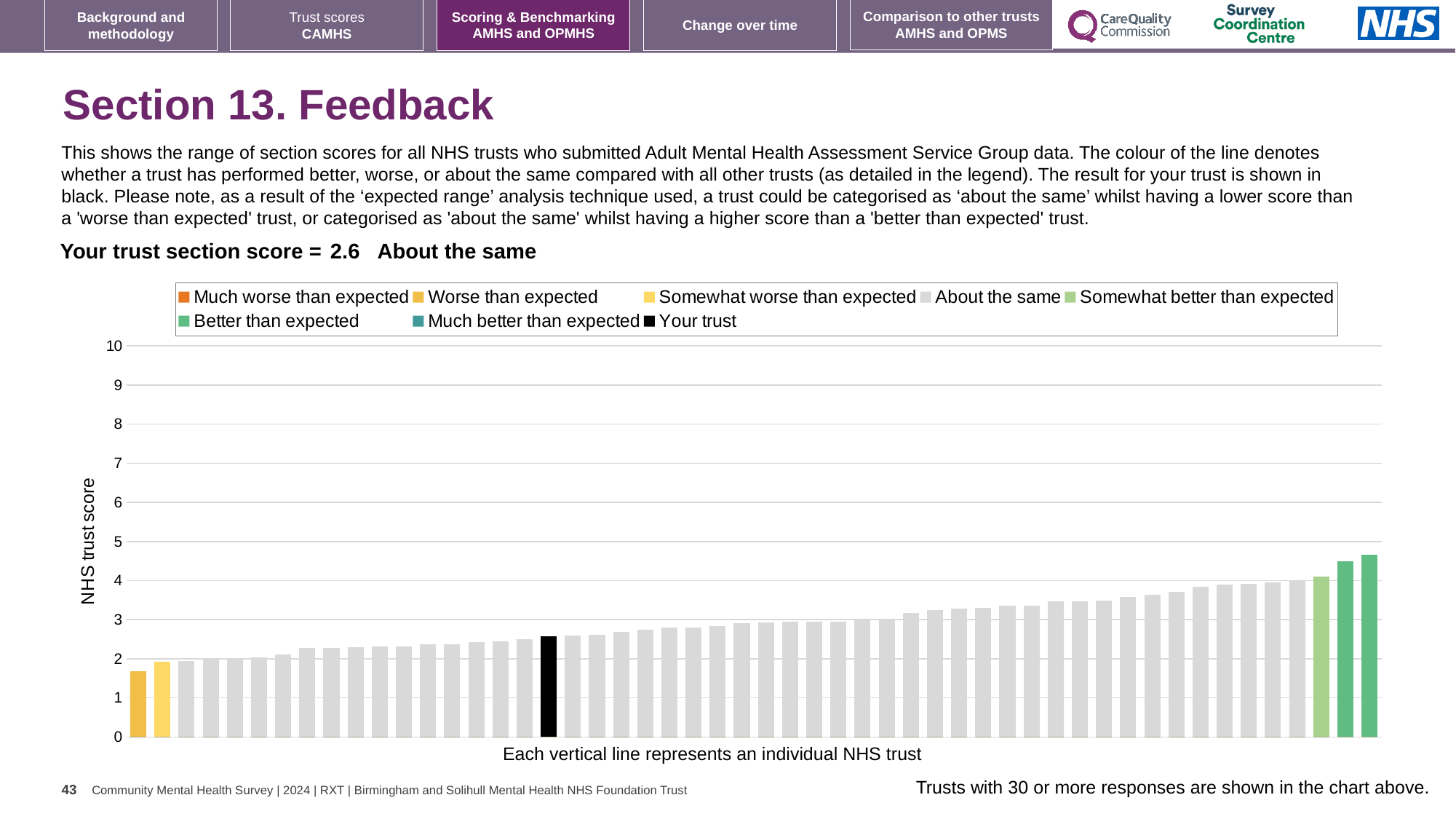
Do the bar values rise or fall from left to right along the x axis? rise Is the tallest bar in the chart greater or less than 5? less What is the section score for your trust shown on the slide? 2.6 Is the tallest bar in the chart greater or less than 4? greater Is the shortest bar in the chart greater or less than 2? less What kind of chart is shown on the slide? bar chart What is the highest value shown on the vertical axis of the chart? 10 How many bars in the chart are coloured green? 3 What is the label on the vertical axis of the chart? NHS trust score How many entries does the chart legend list? 8